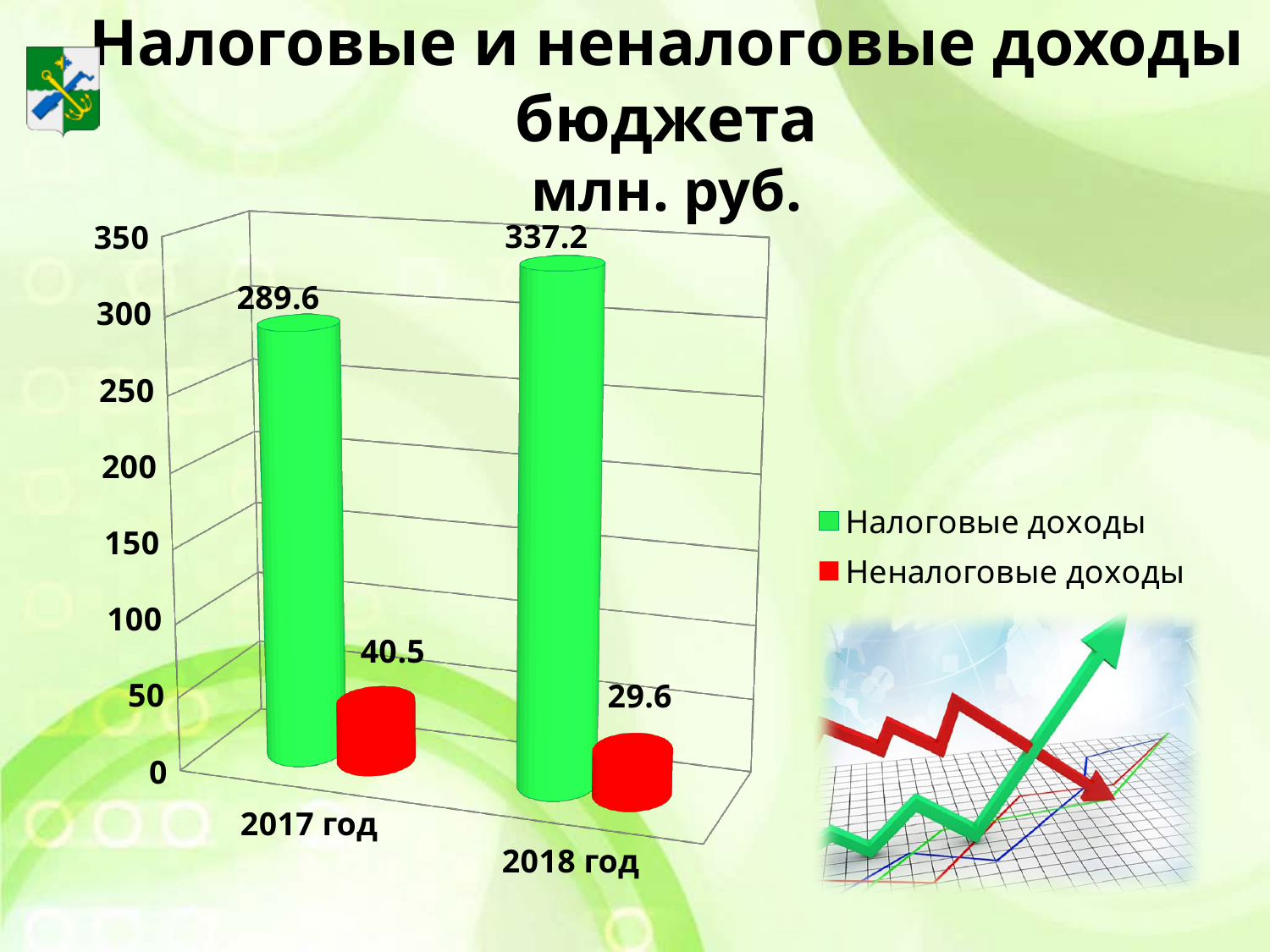
What is the value of Неналоговые доходы for 2018 год? 29.6 What is the value of Налоговые доходы for 2017 год? 289.6 Do the values for Неналоговые доходы rise or fall from 2017 год to 2018 год? Fall Which year has the lower value for Неналоговые доходы? 2018 год What is the difference between Неналоговые доходы in 2017 год and 2018 год? 10.9 What is the value of Неналоговые доходы for 2017 год? 40.5 How many series does the legend list? 2 What kind of chart is shown on the slide? Bar chart What is the difference between Налоговые доходы in 2018 год and 2017 год? 47.6 Which year has the higher value for Налоговые доходы? 2018 год What is the value of Налоговые доходы for 2018 год? 337.2 Which is larger: Налоговые доходы in 2017 год or Неналоговые доходы in 2017 год? Налоговые доходы in 2017 год